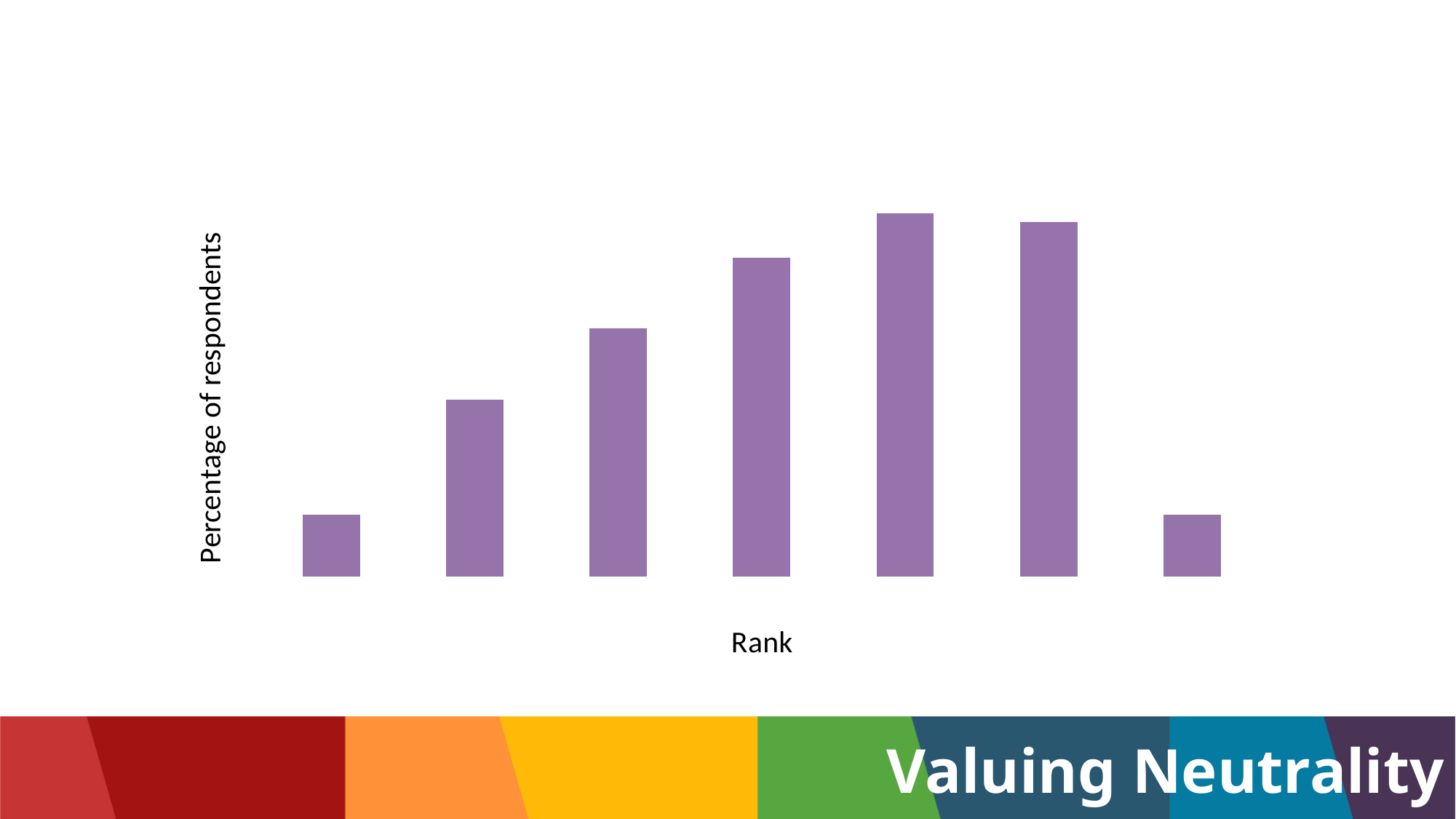
Which is taller in the chart, the sixth bar from the left or the seventh bar from the left? The sixth bar Which is taller in the chart, the first bar from the left or the third bar from the left? The third bar Do the bar heights rise or fall from the first bar to the fifth bar along the x axis? Rise What is the title of the vertical axis of the chart? Percentage of respondents What kind of chart is shown on the slide? Bar chart Do the bar heights rise or fall from the fifth bar to the seventh bar along the x axis? Fall Which is taller in the chart, the second bar from the left or the fourth bar from the left? The fourth bar What is the title of the horizontal axis of the chart? Rank How many bars are plotted in the chart? 7